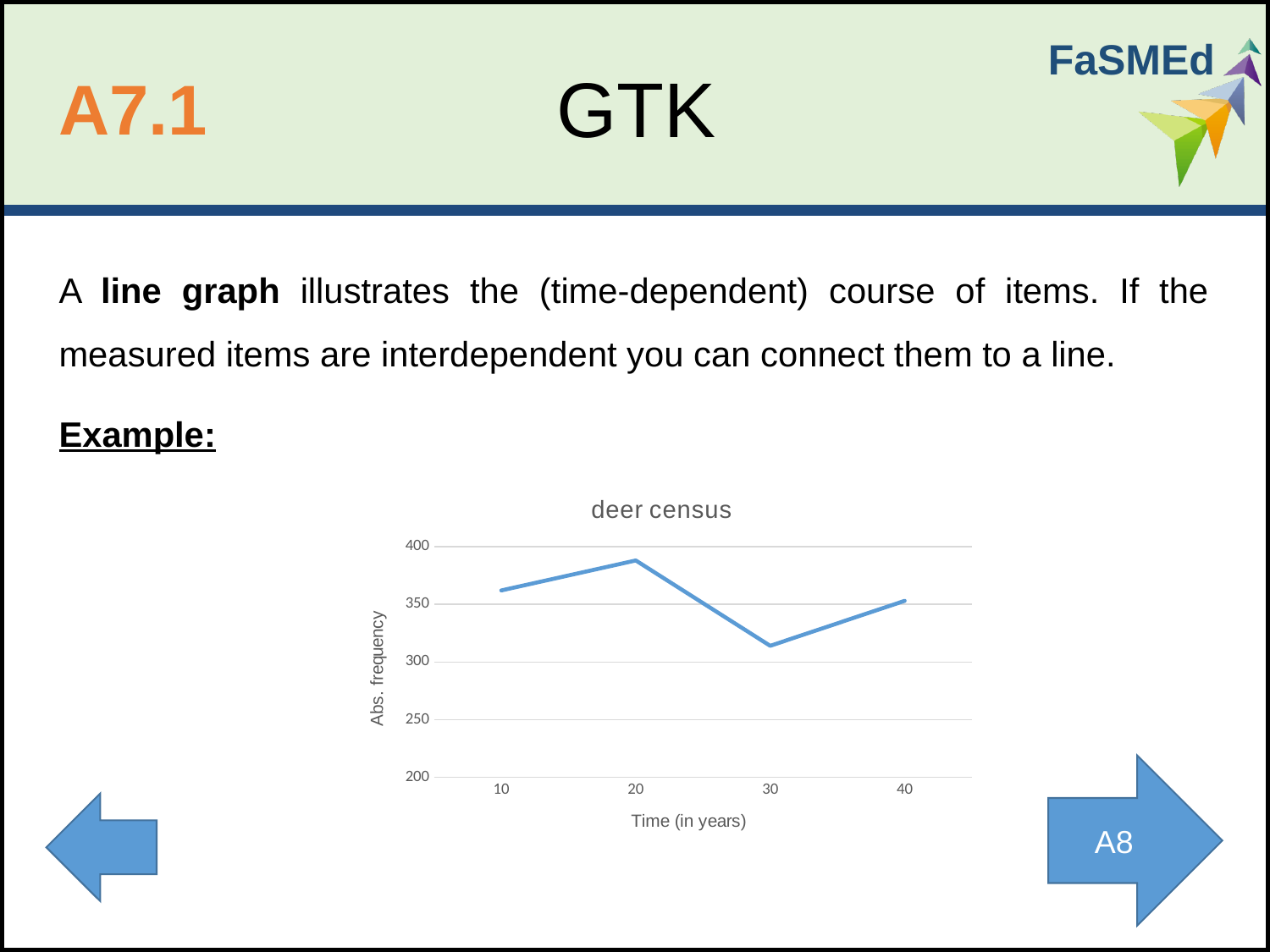
How many data points are plotted on the line? 4 What kind of chart is shown on the slide? line chart Is the value at 40 years greater or less than 300? greater Is the value at 10 years greater or less than 400? less At which time (in years) is the absolute frequency highest? 20 At which time (in years) is the absolute frequency lowest? 30 Is the value at 20 years greater or less than 350? greater What is the title of the chart? deer census Does the line rise or fall between 20 years and 30 years? fall Which is larger, the value at 10 years or the value at 30 years? 10 years What is the label of the x axis? Time (in years)